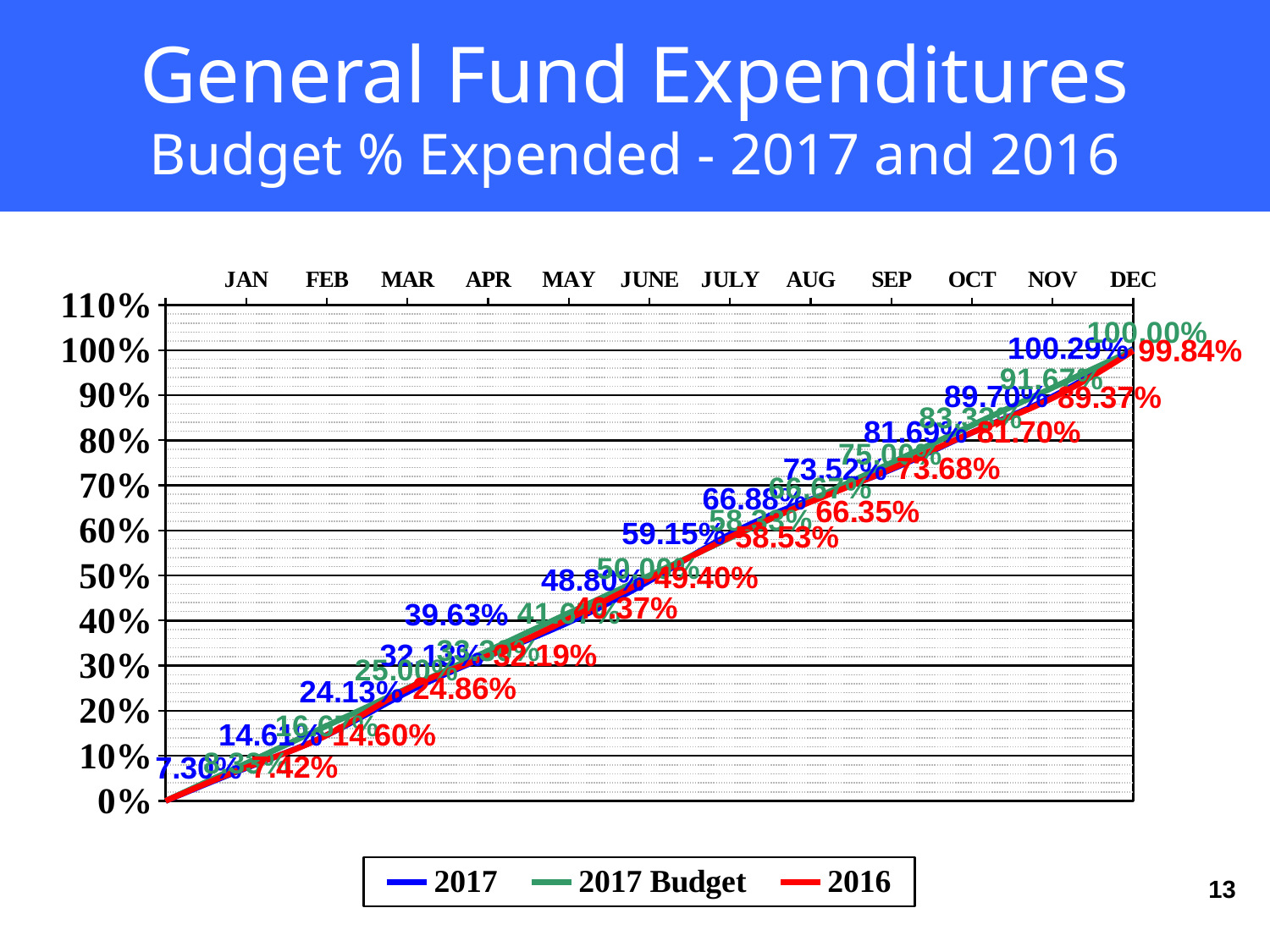
What is the difference between the 2017 and 2016 values for DEC? 0.45% What is the 2016 value for NOV? 89.37% How many series does the legend list? 3 What is the 2017 Budget value for SEP? 75.00% Which colour represents the 2016 series in the legend? Red Do the 2017 values rise or fall from JAN to DEC? Rise Which is larger for MAY, the 2017 value or the 2016 value? 2016 What is the 2017 value for DEC? 100.29% What is the 2017 value for MAY? 39.63% What is the 2016 value for JULY? 58.53% What kind of chart is shown on the slide? Line chart How many months are plotted along the x axis? 12